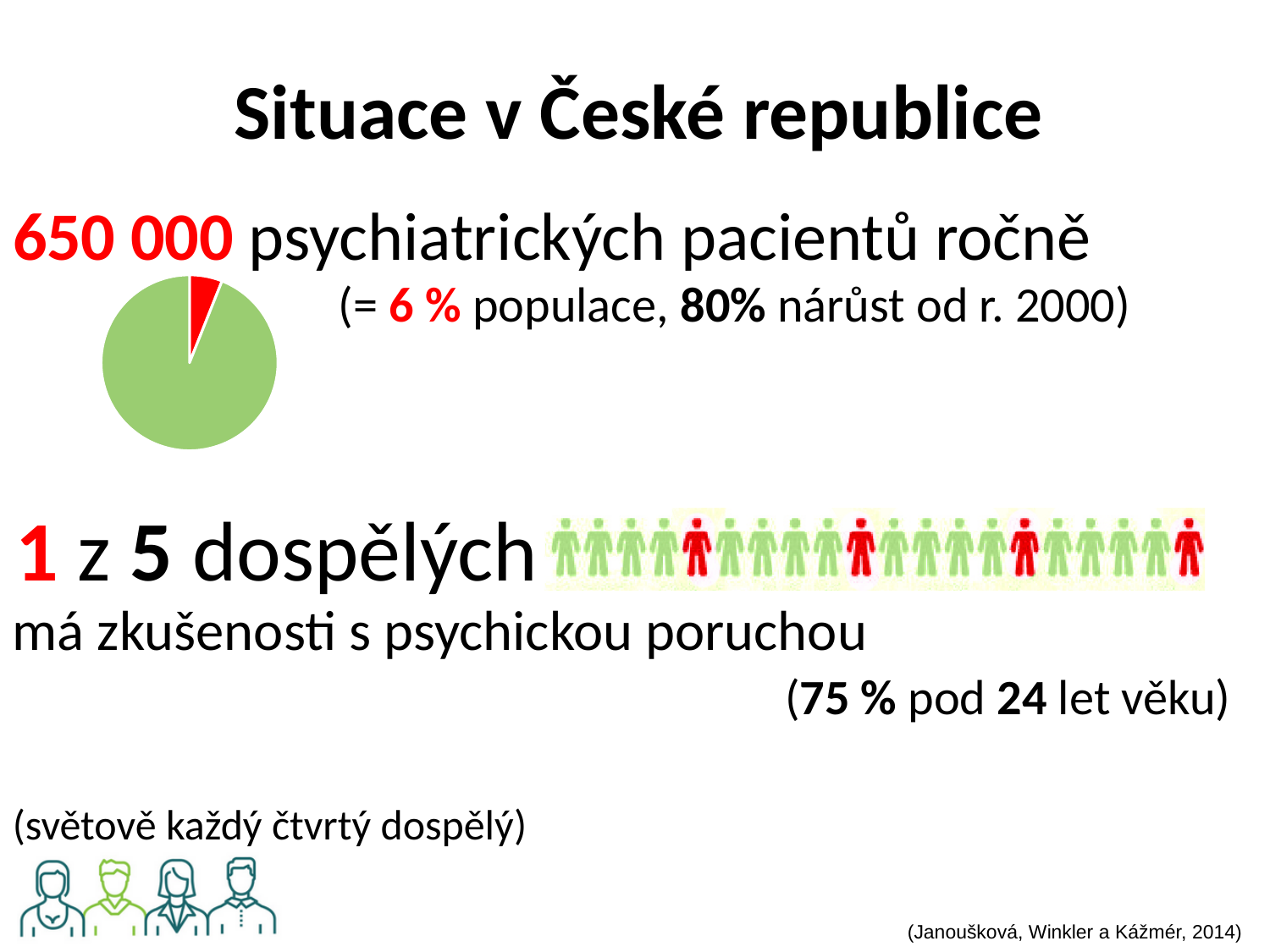
According to the slide, how many psychiatric patients per year does the pie chart relate to? 650 000 According to the slide, what is the percentage increase in psychiatric patients since 2000? 80% What kind of chart is shown next to the text '650 000 psychiatrických pacientů ročně'? pie chart How many slices does the pie chart have? 2 In the row of person icons, what proportion of adults is highlighted in red? 1 z 5 What colour is the small slice of the pie chart? red Which slice of the pie chart is larger, the green one or the red one? green What share of the population does the red slice of the pie chart represent? 6 % What colour is the large slice of the pie chart? green